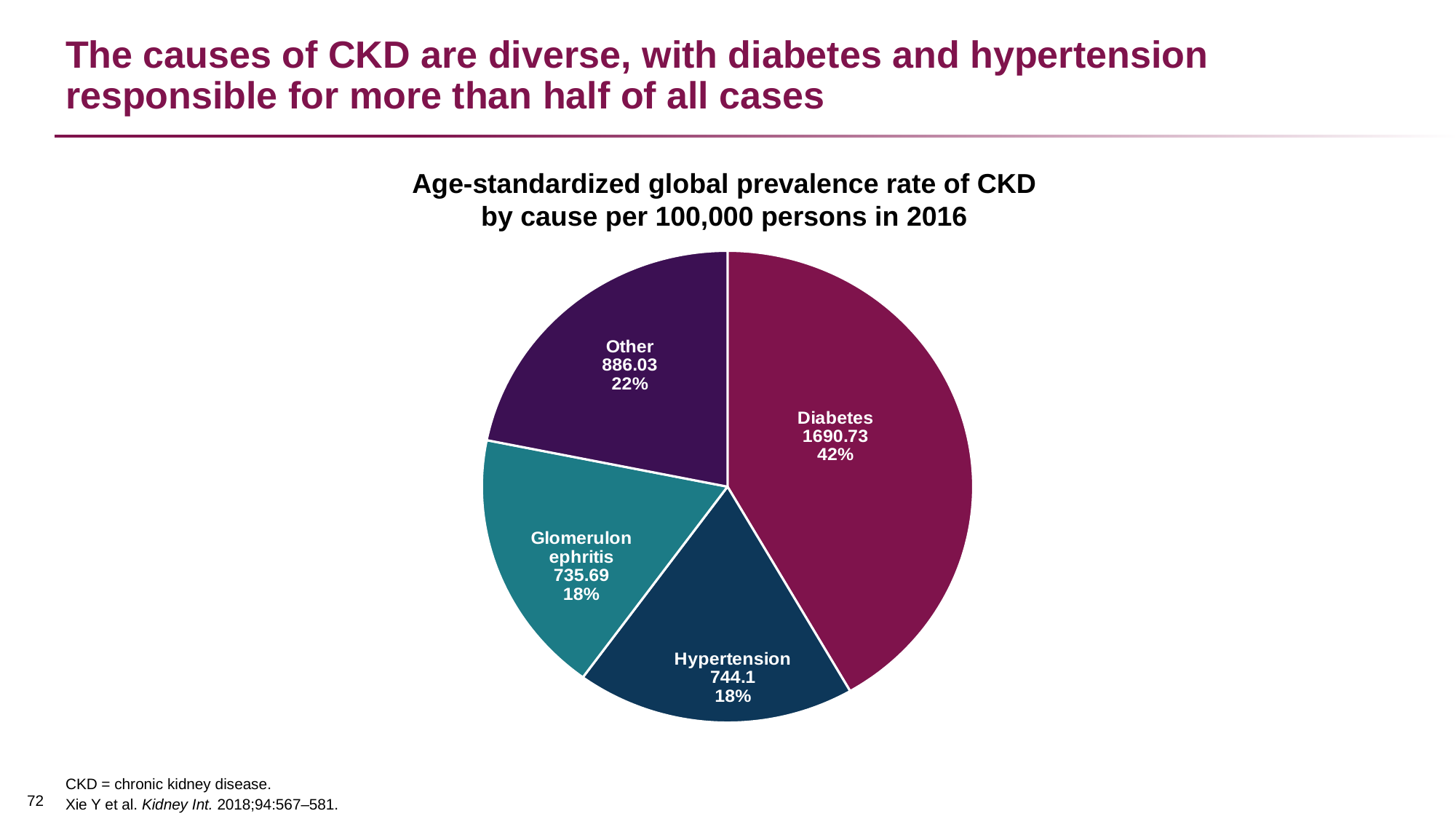
Which cause has the highest prevalence rate? Diabetes What is the difference between the prevalence rates for Diabetes and Other? 804.70 What share of the pie does Diabetes account for? 42% What is the prevalence rate for Hypertension? 744.1 What is the prevalence rate for Glomerulonephritis? 735.69 What is the prevalence rate for Diabetes in the pie chart? 1690.73 What type of chart is shown on the slide? Pie chart What share of the pie does the Other category account for? 22% How many causes are shown in the pie chart? 4 What is the prevalence rate for the Other category? 886.03 Which is larger, the prevalence rate for Other or for Hypertension? Other Which cause has the lowest prevalence rate? Glomerulonephritis